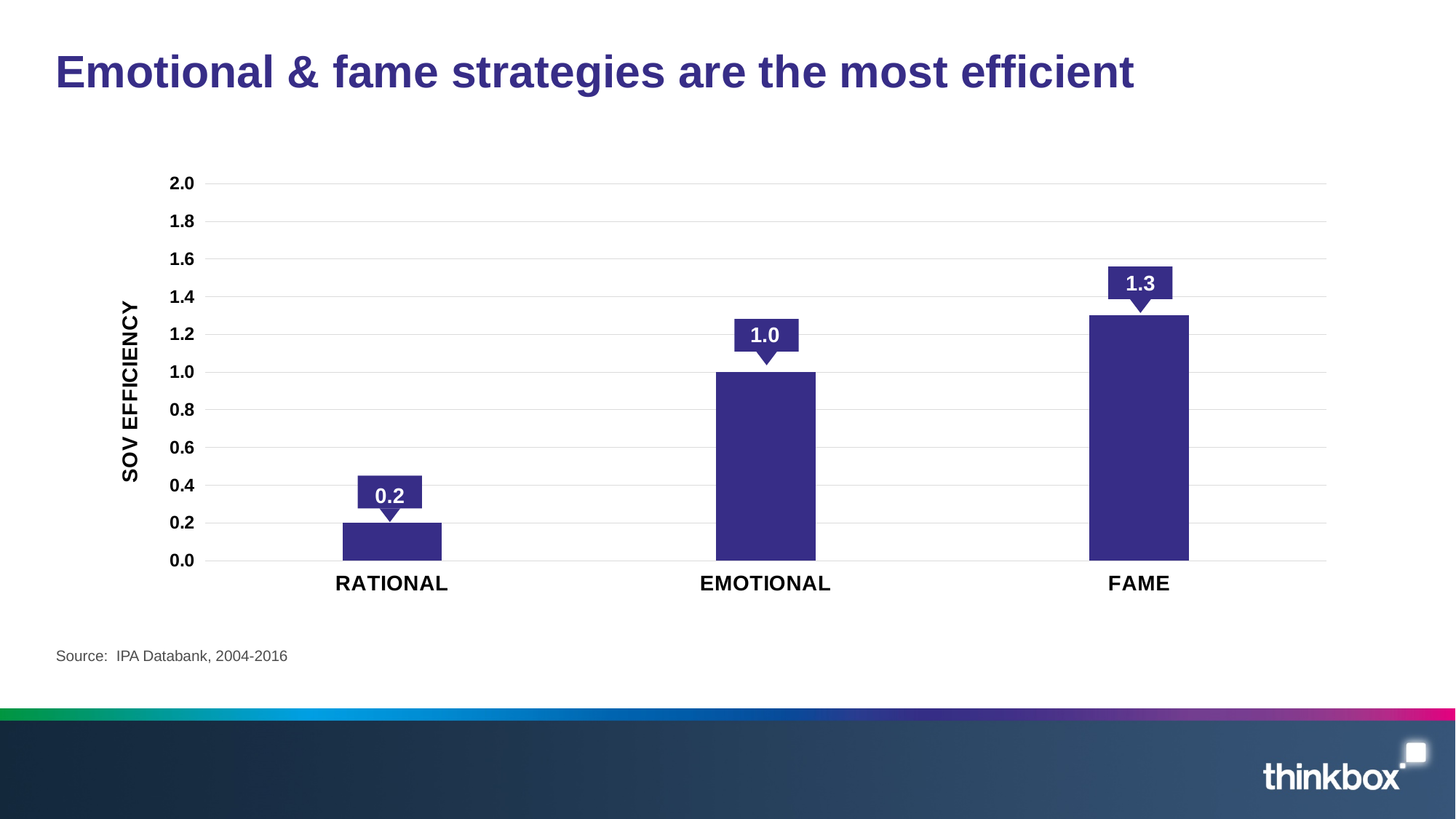
Is the SOV efficiency for FAME greater or less than 1.2? greater How many categories are shown on the x axis? 3 What kind of chart is shown on the slide? Bar chart Which has a higher SOV efficiency, EMOTIONAL or FAME? FAME What is the difference in SOV efficiency between FAME and RATIONAL? 1.1 Which category has the lowest SOV efficiency? RATIONAL What is the SOV efficiency value for RATIONAL? 0.2 What is the SOV efficiency value for FAME? 1.3 What is the SOV efficiency value for EMOTIONAL? 1.0 What is the difference in SOV efficiency between EMOTIONAL and RATIONAL? 0.8 Which category has the highest SOV efficiency? FAME What is the label of the y axis? SOV EFFICIENCY